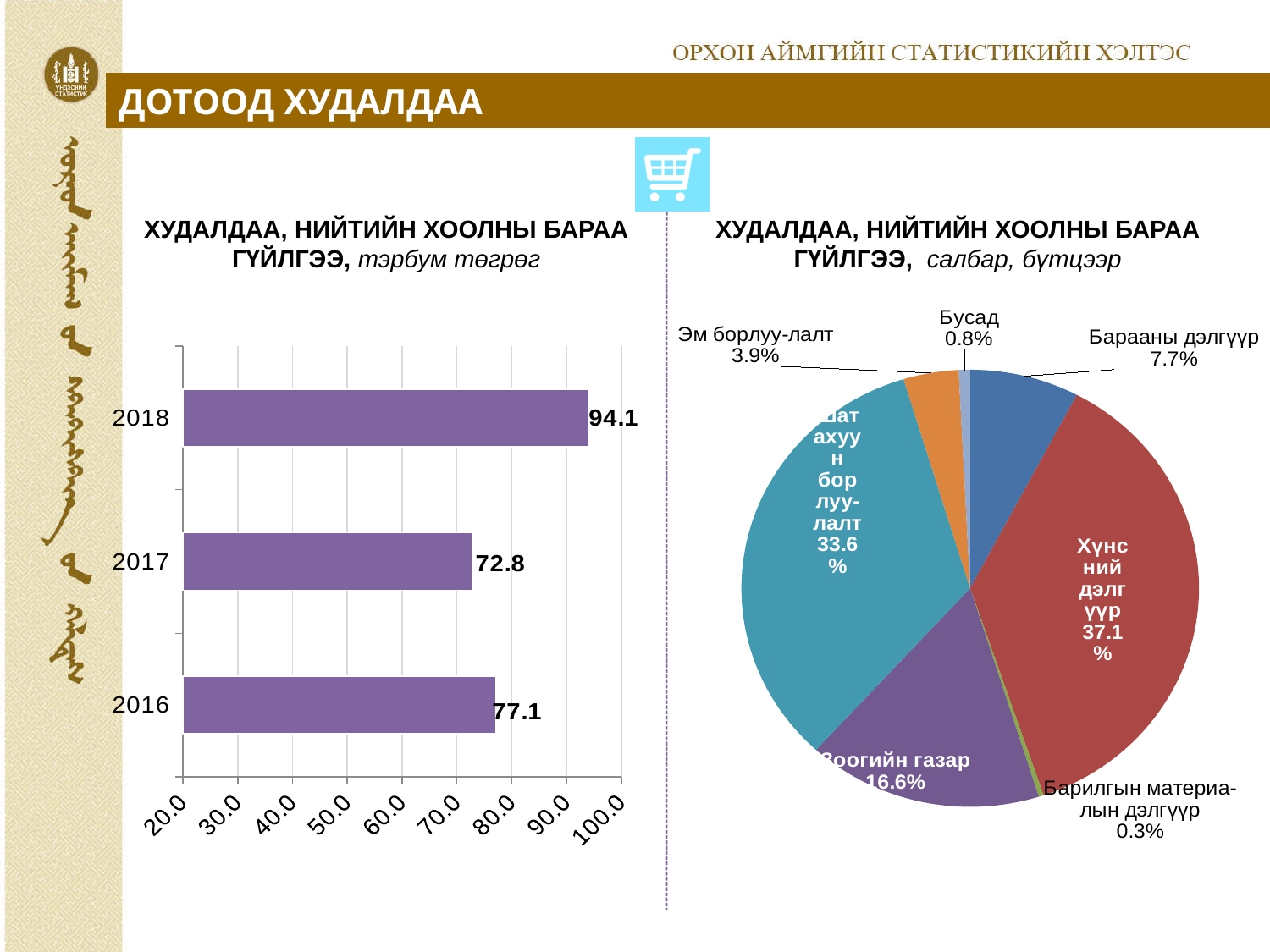
On the right pie chart, what share does Хүнсний дэлгүүр have? 37.1% On the left bar chart, what is the value for 2017? 72.8 On the left bar chart, which year has the lowest value? 2017 On the left bar chart, which year has the highest value? 2018 On the left bar chart, what is the value for 2018? 94.1 What kind of chart is the left chart? bar chart On the right pie chart, what share does Зоогийн газар have? 16.6% On the right pie chart, which category has the smallest share? Барилгын материалын дэлгүүр On the left bar chart, how many years are shown? 3 On the left bar chart, which is larger, the value for 2016 or the value for 2017? 2016 On the left bar chart, what is the difference between the values for 2018 and 2017? 21.3 On the left bar chart, what is the value for 2016? 77.1